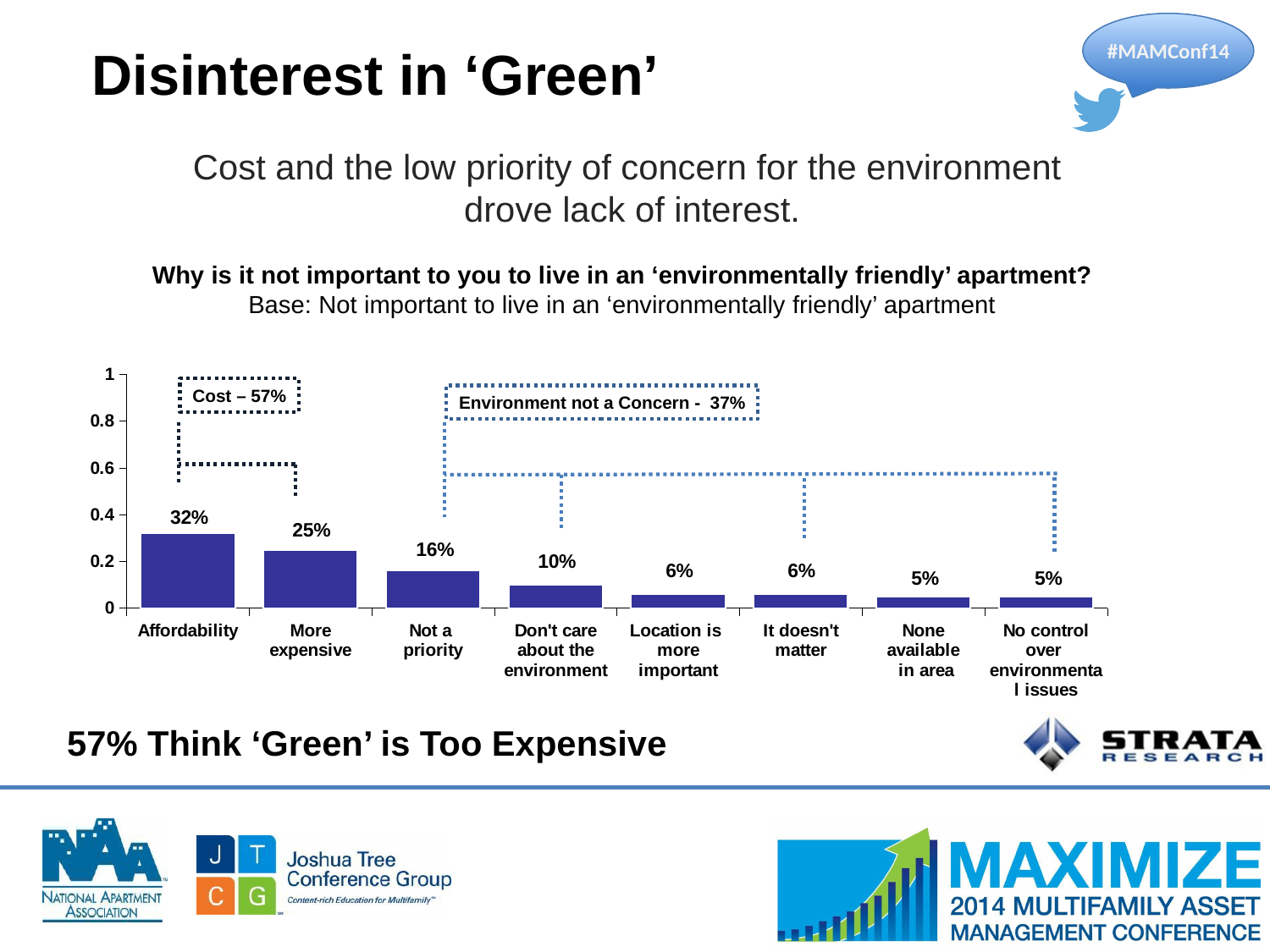
Which category has the highest value in the chart? Affordability What is the difference between the values for Affordability and 'More expensive'? 7% Which is larger, the value for 'Not a priority' or the value for 'Don't care about the environment'? Not a priority What kind of chart is shown on the slide? Bar chart Do the values rise or fall moving from left to right along the x axis? Fall What is the value for 'Don't care about the environment'? 10% What is the combined percentage for the 'Environment not a Concern' group as labelled on the chart? 37% How many categories are shown on the x axis of the chart? 8 What is the value for 'Not a priority'? 16% Is the value for Affordability greater or less than 0.2 on the y axis? greater What percentage of respondents cited Affordability as the reason? 32% What is the combined percentage for the 'Cost' group as labelled on the chart? 57%